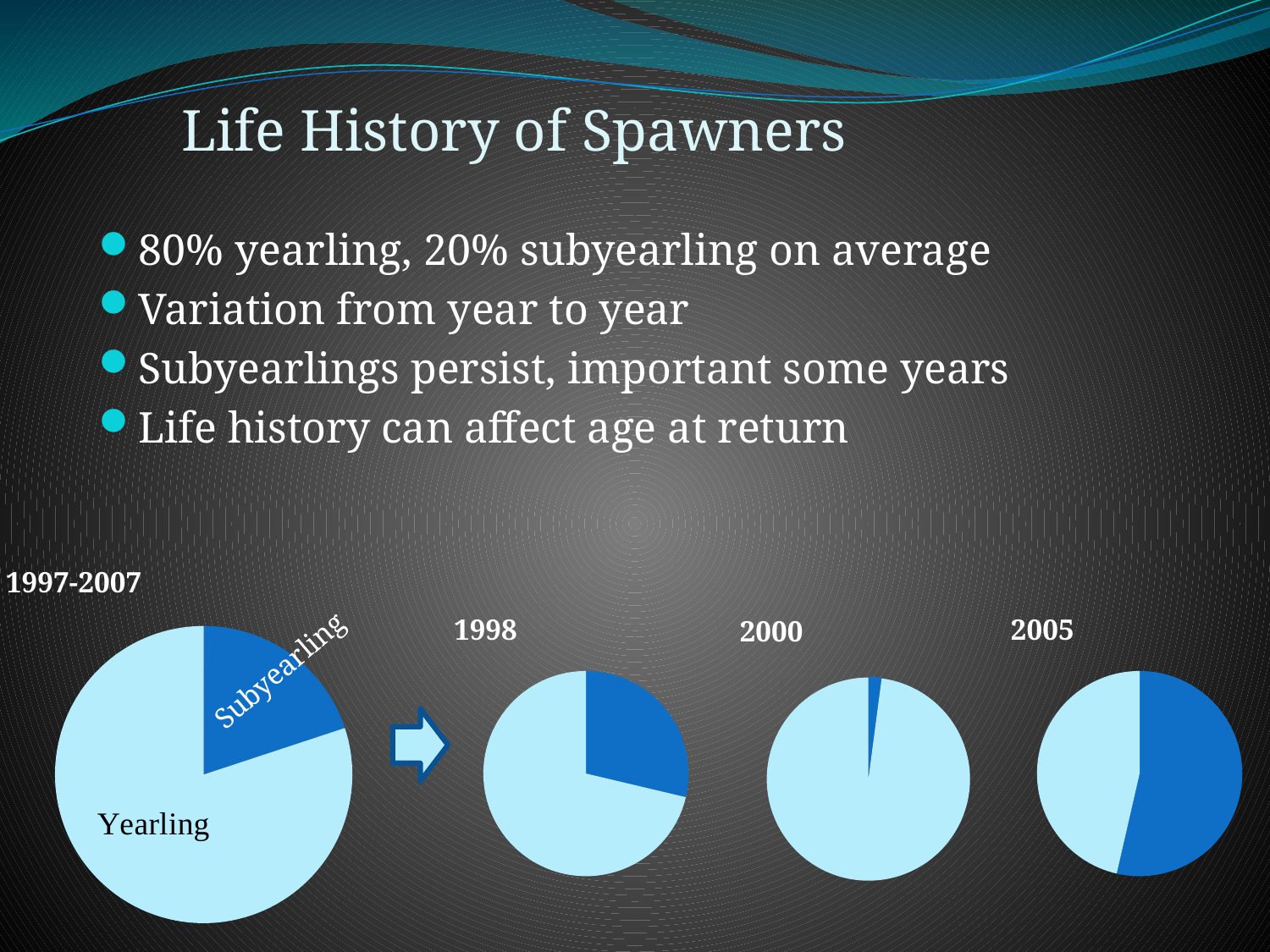
How many categories does each pie chart divide the spawners into? 2 In the 2000 pie chart, which slice is larger, Yearling or Subyearling? Yearling Among the 1998, 2000 and 2005 pie charts, which year has the largest Subyearling share? 2005 Is the Subyearling share larger in the 1998 pie chart or the 2000 pie chart? 1998 How many pie charts are shown on the slide? 4 In the 1997-2007 pie chart, what are the two slices labelled? Yearling and Subyearling Is the Subyearling share larger in the 1998 pie chart or the 2005 pie chart? 2005 Among the 1998, 2000 and 2005 pie charts, which year has the smallest Subyearling share? 2000 In the 1997-2007 pie chart, which colour represents the Subyearling slice? Dark blue What kind of charts are shown at the bottom of the slide? Pie charts